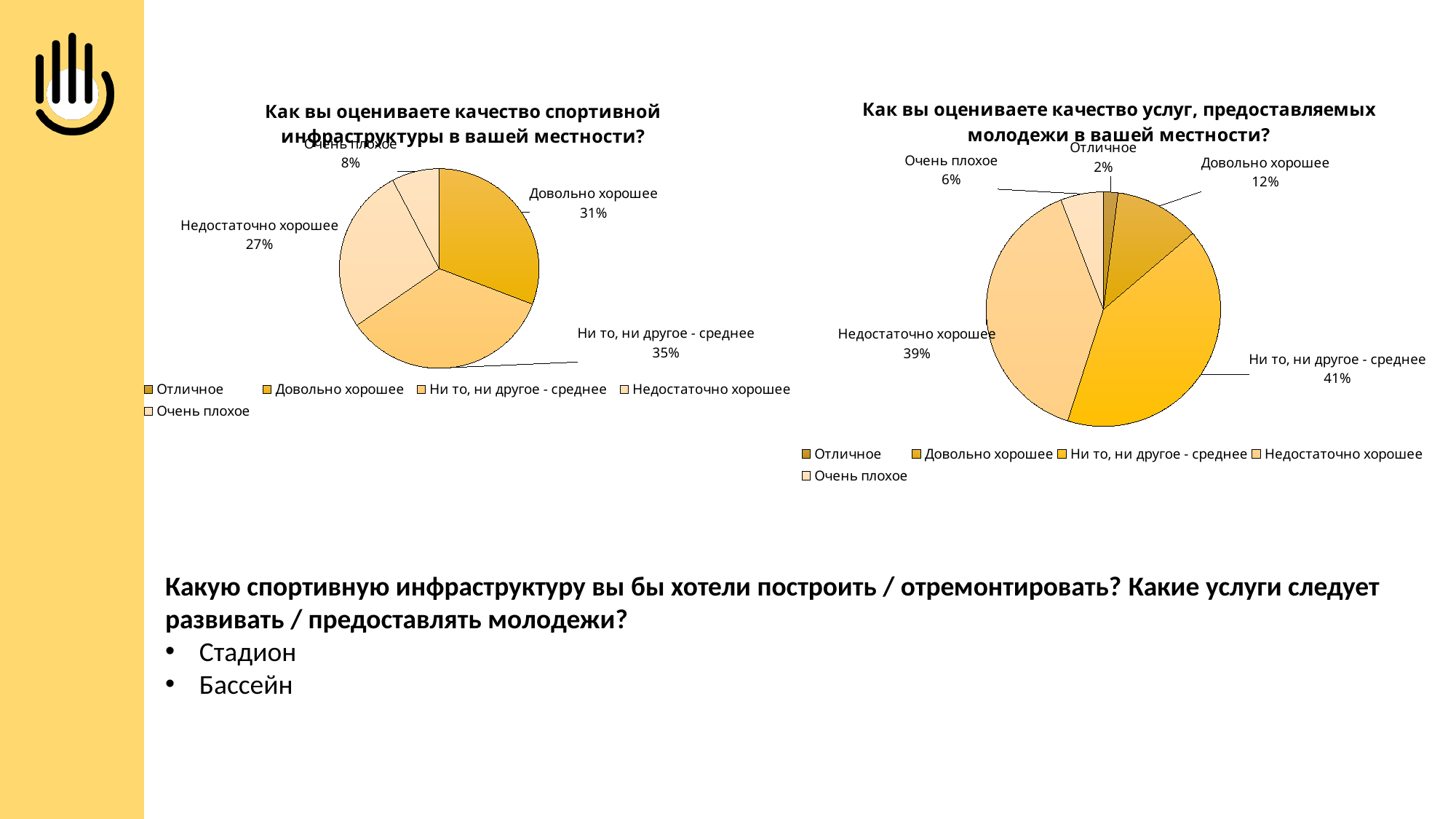
What type of chart is used for the left chart on the slide? Pie chart In the right chart (quality of services for youth), what is the difference between the shares for "Ни то, ни другое - среднее" and "Довольно хорошее"? 29% In the right chart (quality of services for youth), what share of respondents answered "Недостаточно хорошее"? 39% In the left chart (sports infrastructure quality), which answer has the largest share? Ни то, ни другое - среднее In the left chart (sports infrastructure quality), what percentage answered "Очень плохое"? 8% In the right chart (quality of services for youth), which is larger: the share for "Довольно хорошее" or for "Очень плохое"? Довольно хорошее In the right chart (quality of services for youth), what percentage answered "Отличное"? 2% In the left chart (sports infrastructure quality), what share of respondents answered "Ни то, ни другое - среднее"? 35% In the right chart (quality of services for youth), how many slices does the pie have? 5 In the left chart (sports infrastructure quality), what is the difference between the shares for "Довольно хорошее" and "Недостаточно хорошее"? 4% How many entries does the legend of the right chart (quality of services for youth) list? 5 In the right chart (quality of services for youth), which answer has the smallest share? Отличное